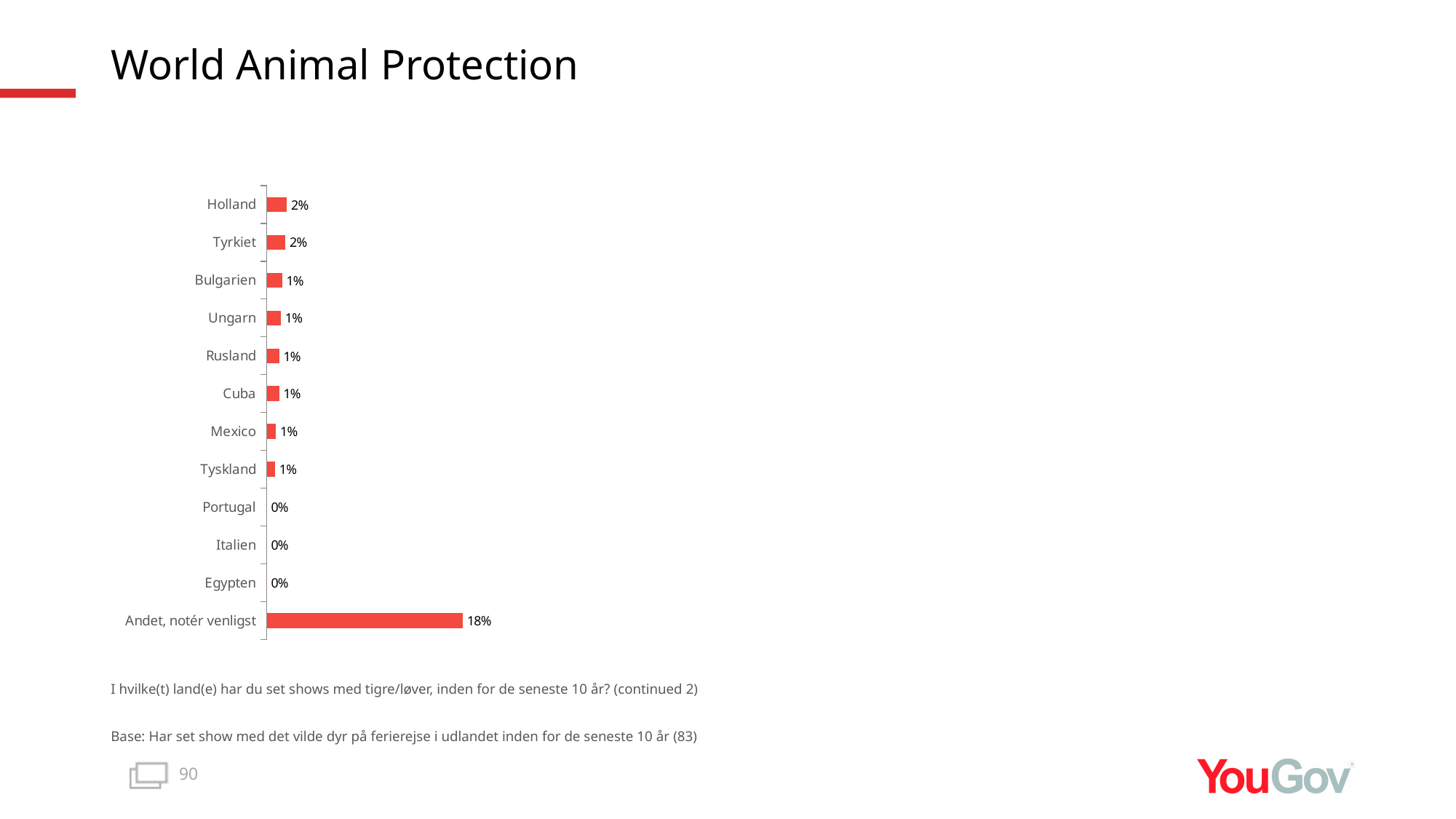
Which is larger, the value for Holland or the value for Bulgarien? Holland What is the value for Holland? 2% What kind of chart is shown on the slide? Bar chart How many categories are shown in the chart? 12 What is the value for Egypten? 0% What is the value for Portugal? 0% What is the value for Andet, notér venligst? 18% How many categories have a value of 0%? 3 What is the value for Rusland? 1% What is the difference between the values for Andet, notér venligst and Tyrkiet? 16% What colour are the bars in the chart? Red Which category has the highest value? Andet, notér venligst